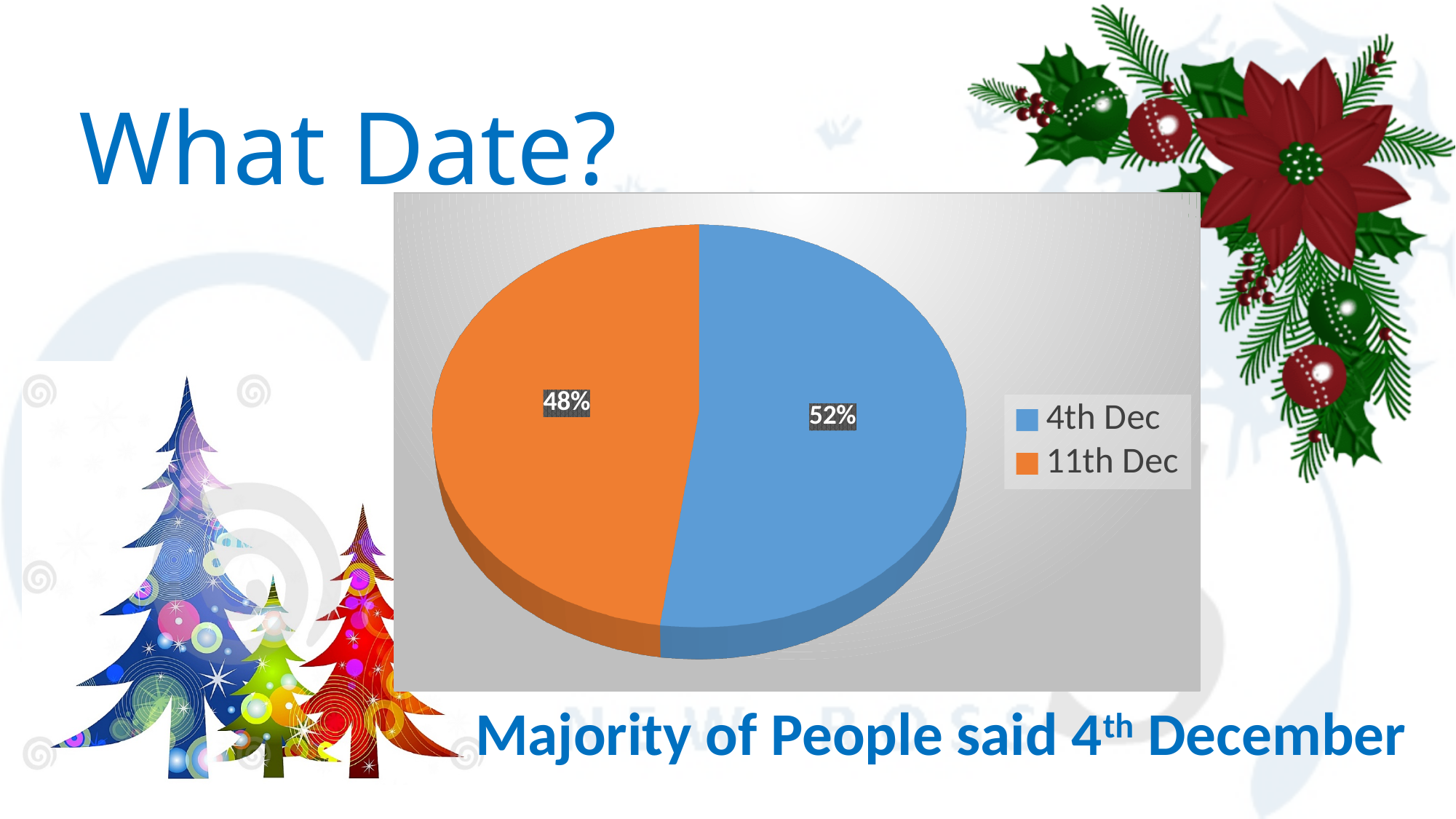
How many slices does the pie chart have? 2 Which date has the smaller slice of the pie? 11th Dec What is the total of the two slice percentages shown? 100% What colour is the slice for 11th Dec? orange What kind of chart is shown on the slide? pie chart Which date has the larger slice of the pie? 4th Dec What is the difference in percentage points between the 4th Dec and 11th Dec slices? 4 How many entries does the legend list? 2 Is the slice for 4th Dec larger or smaller than the slice for 11th Dec? larger What share of the pie is labelled for 4th Dec? 52% What share of the pie is labelled for 11th Dec? 48% What colour is the slice for 4th Dec? blue